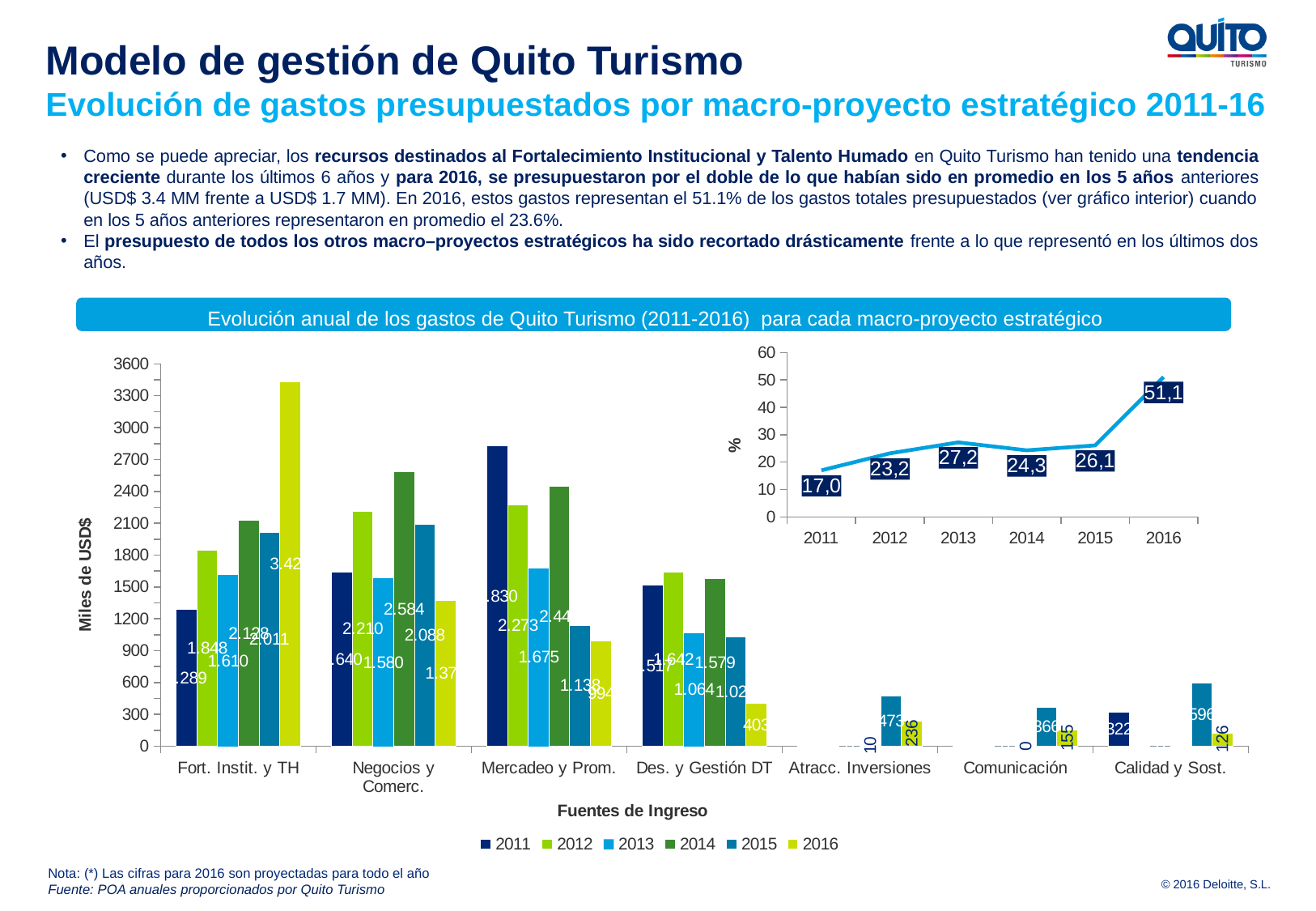
In the line chart (top right), what percentage is shown for 2016? 51,1 What kind of chart is the large chart on the left? bar chart In the bar chart, for Fort. Instit. y TH, which is larger: the 2012 value or the 2013 value? 2012 In the line chart (top right), how many years are plotted? 6 In the bar chart, how many categories are shown on the x axis? 7 In the bar chart, what is the 2015 value for Calidad y Sost.? 596 In the line chart (top right), which year has the lowest percentage? 2011 In the bar chart, is the 2016 value for Fort. Instit. y TH greater or less than 3300? greater In the bar chart, what is the 2014 value for Negocios y Comerc.? 2.584 In the bar chart, what is the 2016 value for Mercadeo y Prom.? 994 In the bar chart, how many series does the legend list? 6 In the line chart (top right), what is the difference between the 2016 and 2015 values? 25,0